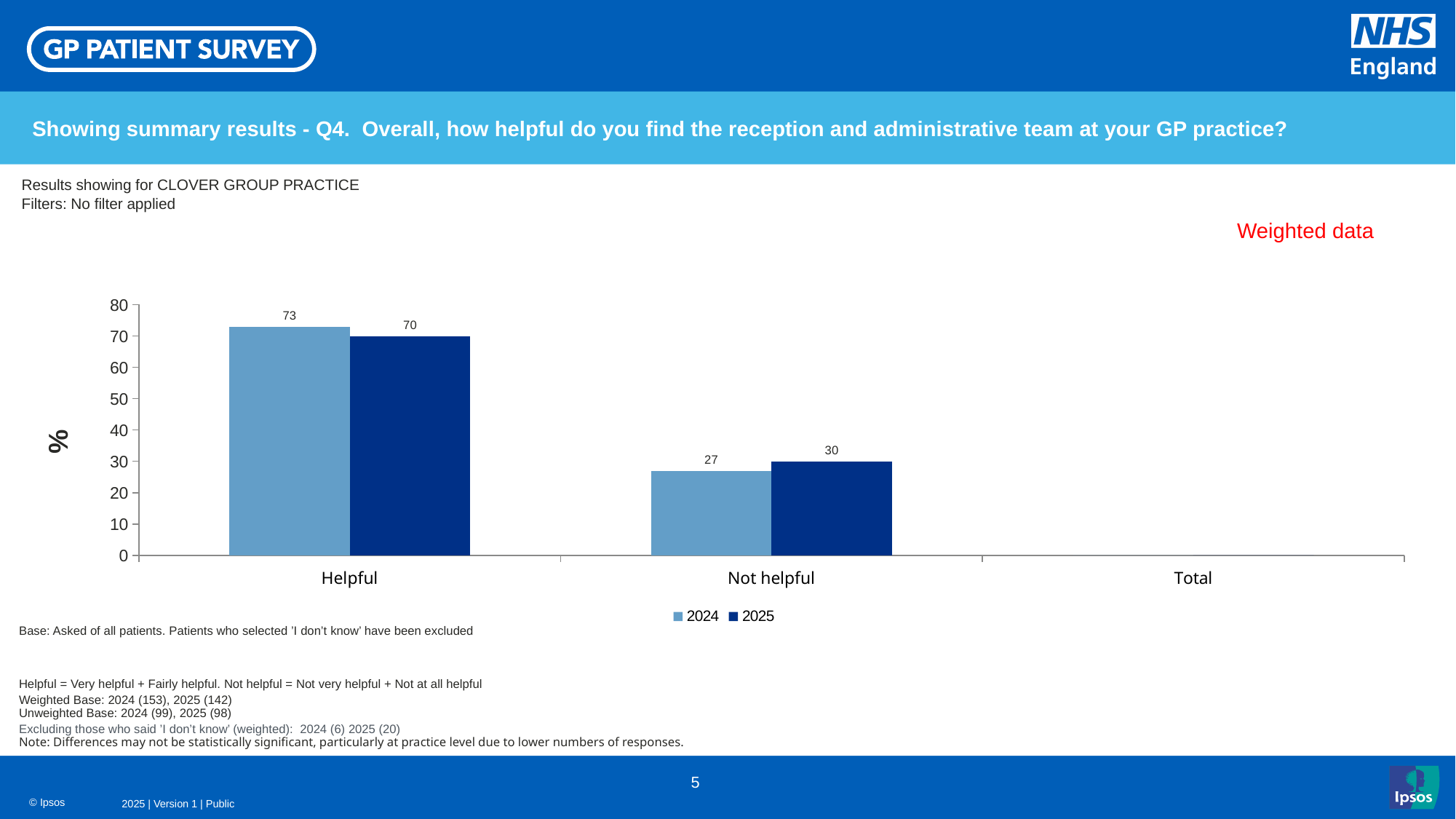
What kind of chart is shown on the slide? Bar chart Which category has the lowest value for 2024? Not helpful What is the value for Not helpful in 2025? 30 What is the value for Helpful in 2024? 73 What is the difference between the 2024 and 2025 values for Helpful? 3 What is the value for Not helpful in 2024? 27 Is the value for Helpful in 2025 greater or less than 60? greater Which category has the highest value for 2025? Helpful Which is larger for Not helpful: the 2024 value or the 2025 value? 2025 How many series does the legend list? 2 What is the value for Helpful in 2025? 70 What label is shown on the vertical axis? %